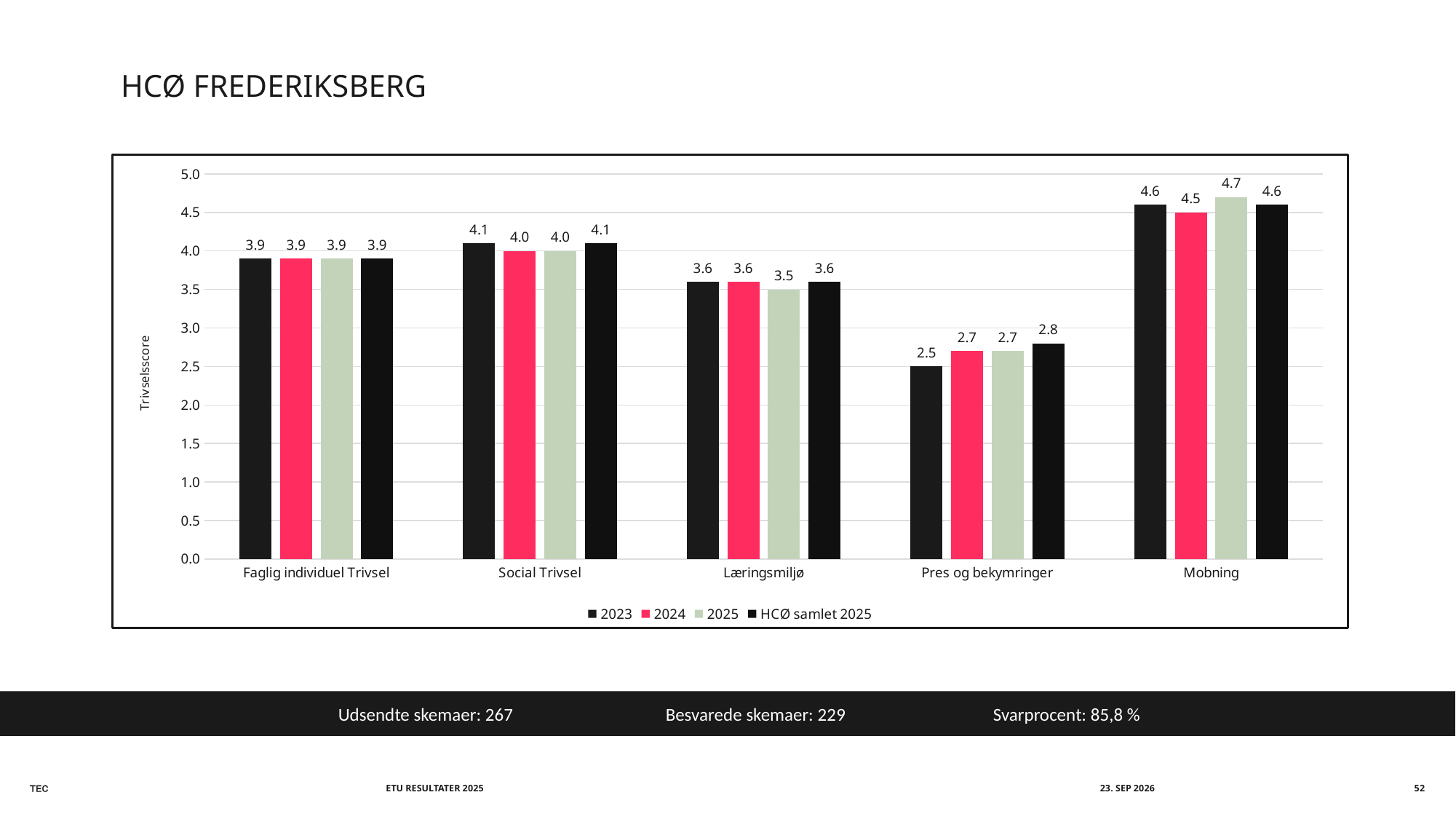
What is the label of the y axis? Trivselsscore How many series does the legend list? 4 What is the HCØ samlet 2025 value for Social Trivsel? 4.1 What is the difference between the 2024 and 2023 values for Pres og bekymringer? 0.2 How many categories are shown on the x axis? 5 Which is larger for Mobning, the 2024 value or the 2025 value? 2025 Which category has the highest 2025 value? Mobning What kind of chart is shown on the slide? bar chart What is the 2025 value for Læringsmiljø? 3.5 Which category has the lowest 2023 value? Pres og bekymringer What is the 2025 value for Mobning? 4.7 What is the 2024 value for Pres og bekymringer? 2.7